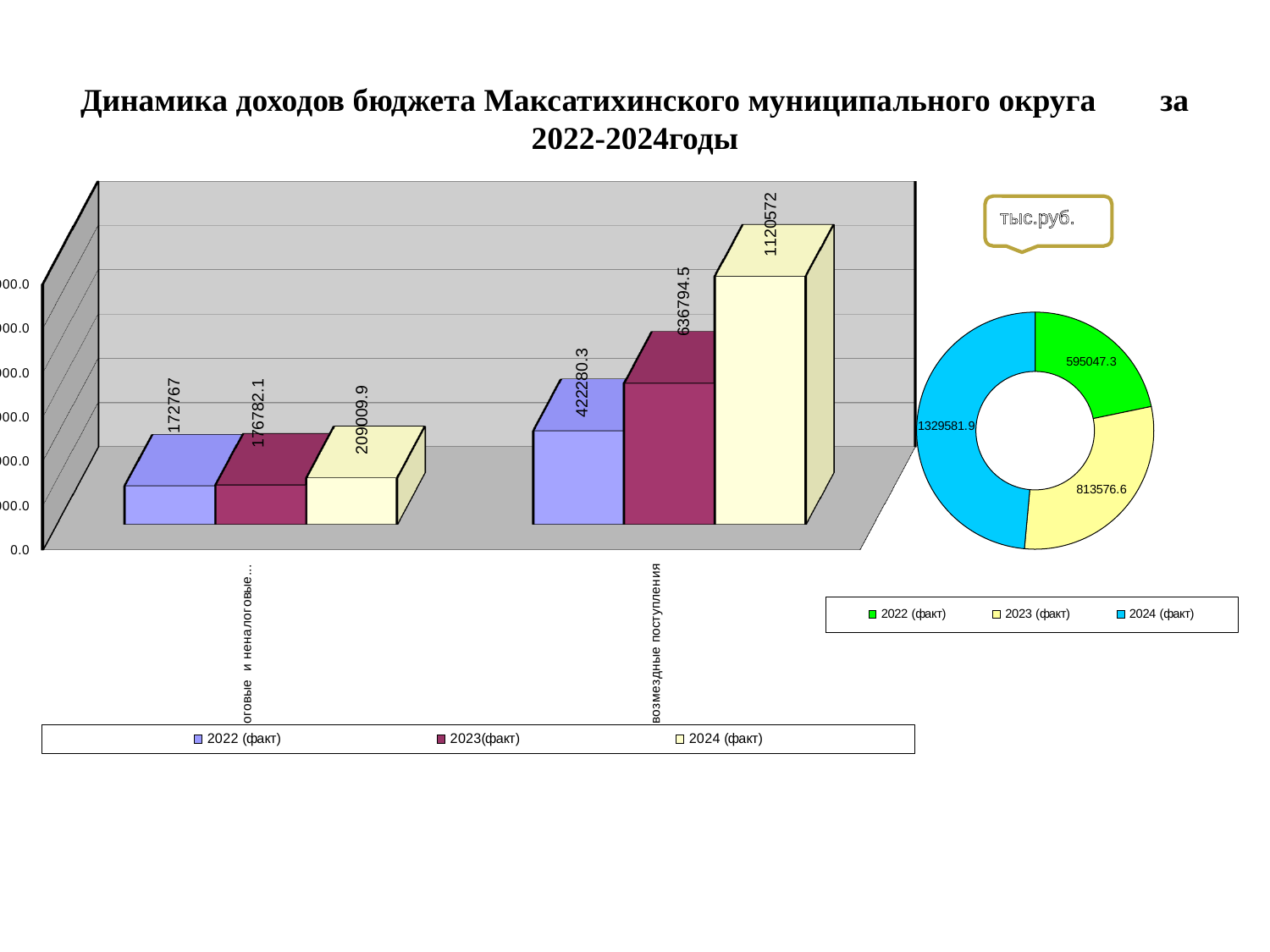
On the bar chart on the left, do the values rise or fall from 2022 to 2024 within each group of bars? rise On the doughnut chart on the right, what is the value for 2024 (факт)? 1329581.9 What kind of chart is the chart on the right of the slide? doughnut chart On the bar chart on the left, what is the value for 2022 (факт) in the left-hand group of bars? 172767 On the doughnut chart on the right, which series has the smallest value? 2022 (факт) On the bar chart on the left, which series has the highest value in the right-hand group of bars? 2024 (факт) On the doughnut chart on the right, what is the difference between the 2024 (факт) and 2023 (факт) values? 516005.3 How many series does the legend of the bar chart on the left list? 3 On the bar chart on the left, what is the value for 2023(факт) in the right-hand group of bars? 636794.5 On the bar chart on the left, what is the value for 2024 (факт) in the right-hand group of bars? 1120572 On the bar chart on the left, what is the difference between the 2024 (факт) and 2022 (факт) values in the left-hand group of bars? 36242.9 On the bar chart on the left, what is the difference between the 2024 (факт) and 2023(факт) values in the right-hand group of bars? 483777.5